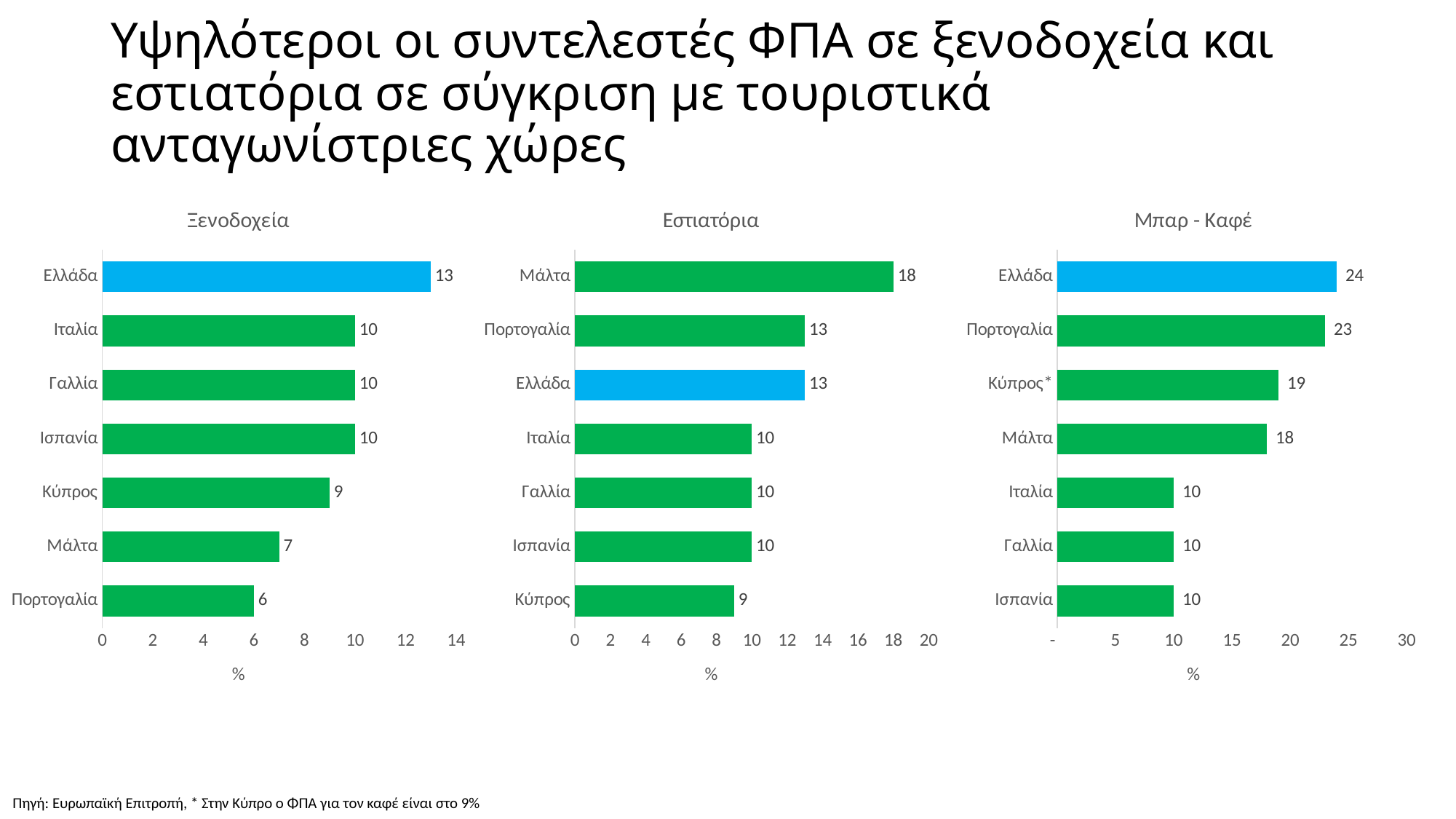
In the Εστιατόρια chart, what is the value for Κύπρος? 9 In the Εστιατόρια chart, which country has the highest value? Μάλτα In the Ξενοδοχεία chart, which country has the lowest value? Πορτογαλία In the Ξενοδοχεία chart, what is the value for Ελλάδα? 13 In the Ξενοδοχεία chart, what is the difference between Ελλάδα and Μάλτα? 6 What type of chart is the Ξενοδοχεία chart? Bar chart In the Μπαρ - Καφέ chart, what is the value for Ελλάδα? 24 How many charts are shown on the slide? 3 In the Μπαρ - Καφέ chart, what is the difference between Ελλάδα and Ισπανία? 14 In the Μπαρ - Καφέ chart, which country has the lowest value? Ιταλία, Γαλλία and Ισπανία (all 10) In the Μπαρ - Καφέ chart, which is larger, Κύπρος* or Μάλτα? Κύπρος* In the Εστιατόρια chart, how many countries are shown? 7